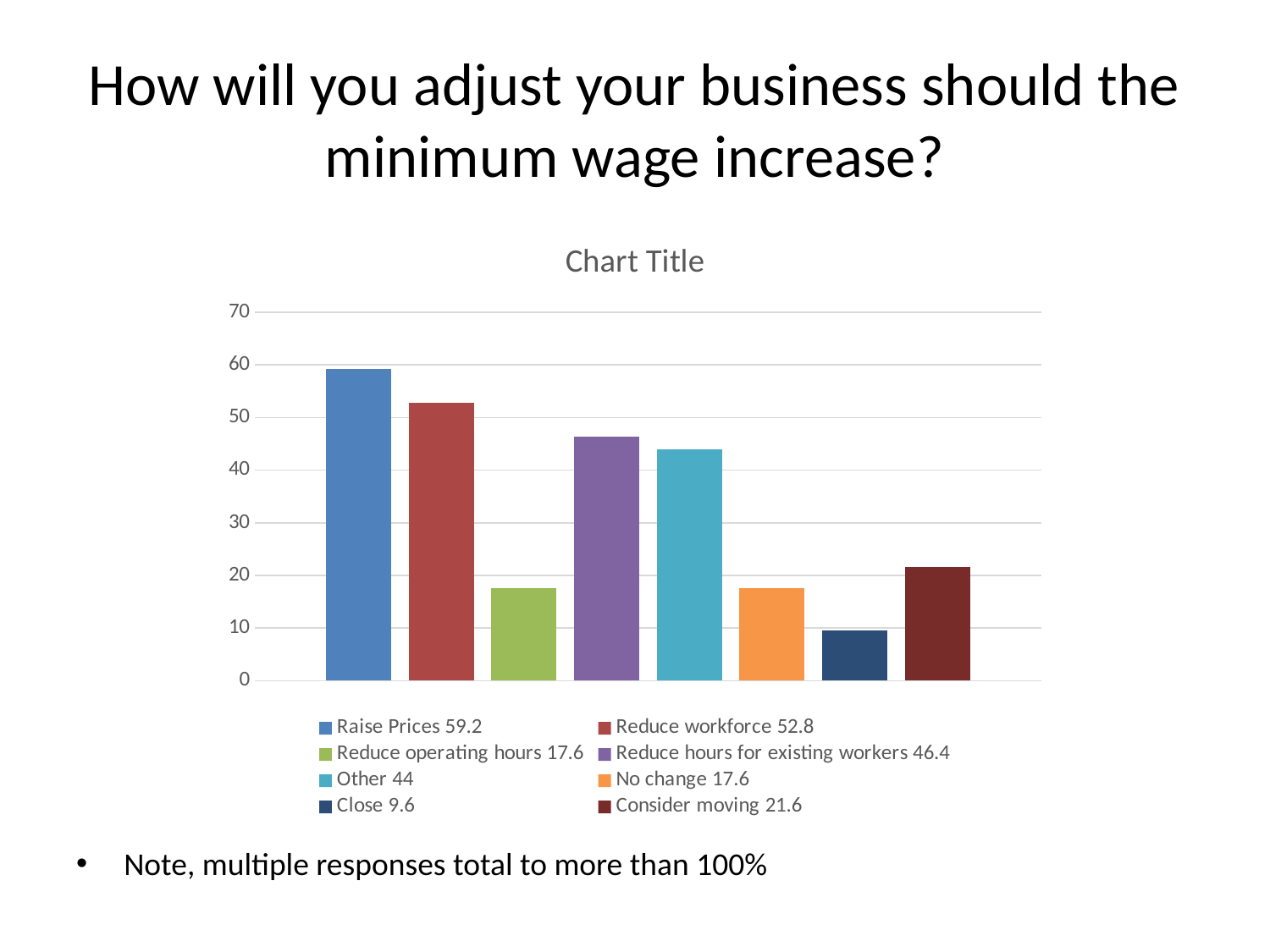
Which is larger, the value for Other or the value for Consider moving? Other What type of chart is shown on the slide? bar chart Which response has the highest value? Raise Prices What is the value for Raise Prices? 59.2 What is the difference between the values for Raise Prices and Reduce workforce? 6.4 Which response has the lowest value? Close What is the value for Reduce hours for existing workers? 46.4 Is the value for Reduce workforce greater or less than 50? greater What is the value for Consider moving? 21.6 What is the value for Close? 9.6 How many entries does the legend list? 8 How many bars are plotted in the chart? 8